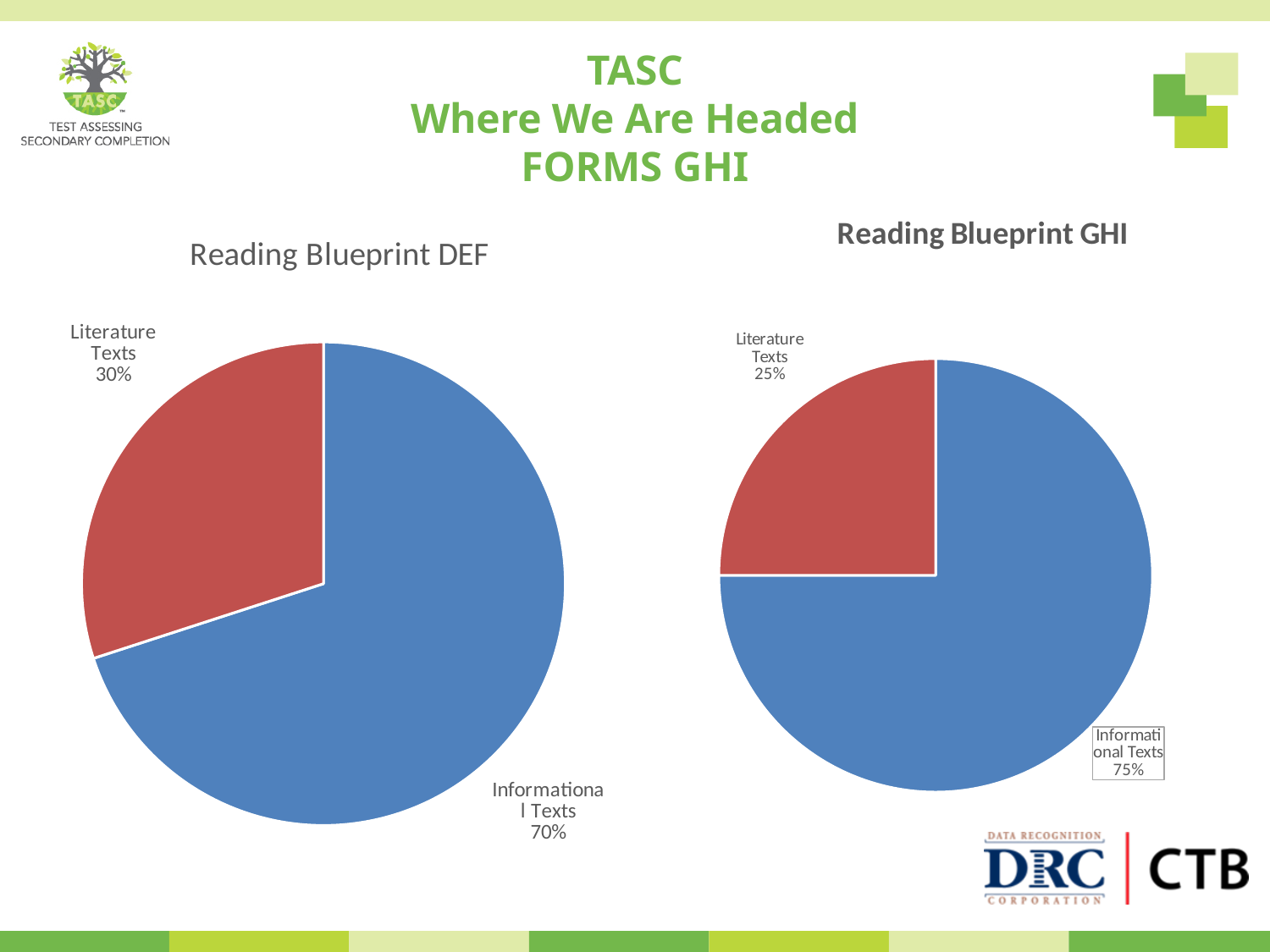
In the Reading Blueprint DEF chart, what share of the pie is Informational Texts? 70% In the Reading Blueprint GHI chart, which category has the smallest slice? Literature Texts In the Reading Blueprint DEF chart, what share of the pie is Literature Texts? 30% In the Reading Blueprint DEF chart, which category has the largest slice? Informational Texts In the Reading Blueprint DEF chart, what is the difference between the Informational Texts and Literature Texts shares? 40% How many slices does the Reading Blueprint GHI pie chart have? 2 In the Reading Blueprint DEF chart, what colour is the Literature Texts slice? Red In the Reading Blueprint GHI chart, what share of the pie is Literature Texts? 25% In the Reading Blueprint GHI chart, what is the difference between the Informational Texts and Literature Texts shares? 50% Which chart has the larger Literature Texts share, Reading Blueprint DEF or Reading Blueprint GHI? Reading Blueprint DEF What type of chart is the Reading Blueprint DEF chart? Pie chart